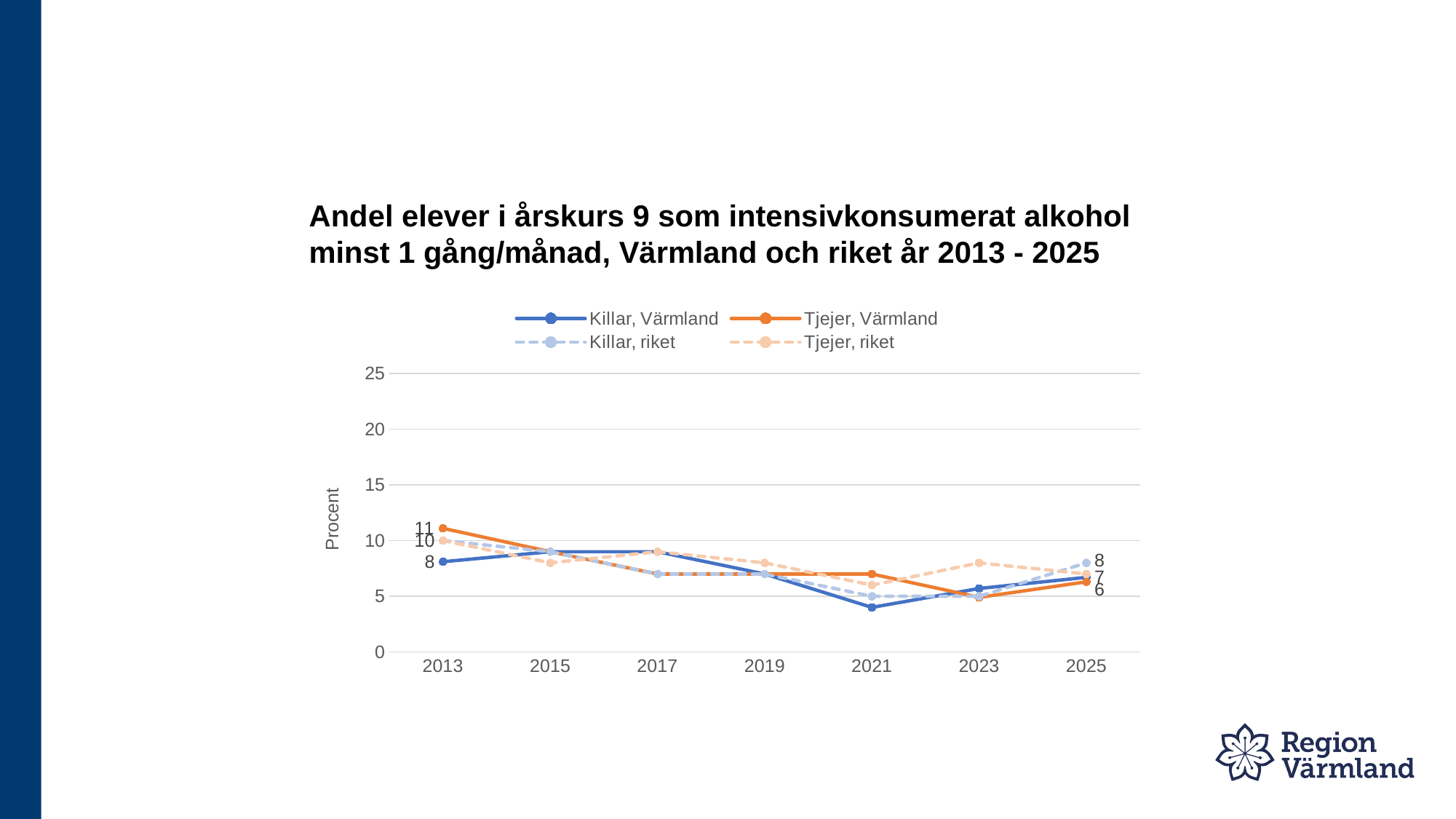
In 2013, which is higher: Killar, Värmland or Tjejer, Värmland? Tjejer, Värmland By how much did the value for Tjejer, Värmland fall from 2013 to 2025? 5 What kind of chart is shown on the slide? Line chart What is the value for Tjejer, Värmland in 2013? 11 How many series does the legend list? 4 What is the value for Tjejer, Värmland in 2025? 6 How many years are shown on the x axis? 7 What is the value for Killar, riket in 2025? 8 Is the value for Killar, Värmland in 2021 greater or less than 5? less In which year is the value for Killar, Värmland lowest? 2021 What is the value for Killar, Värmland in 2013? 8 What is the difference between Tjejer, Värmland and Killar, Värmland in 2013? 3